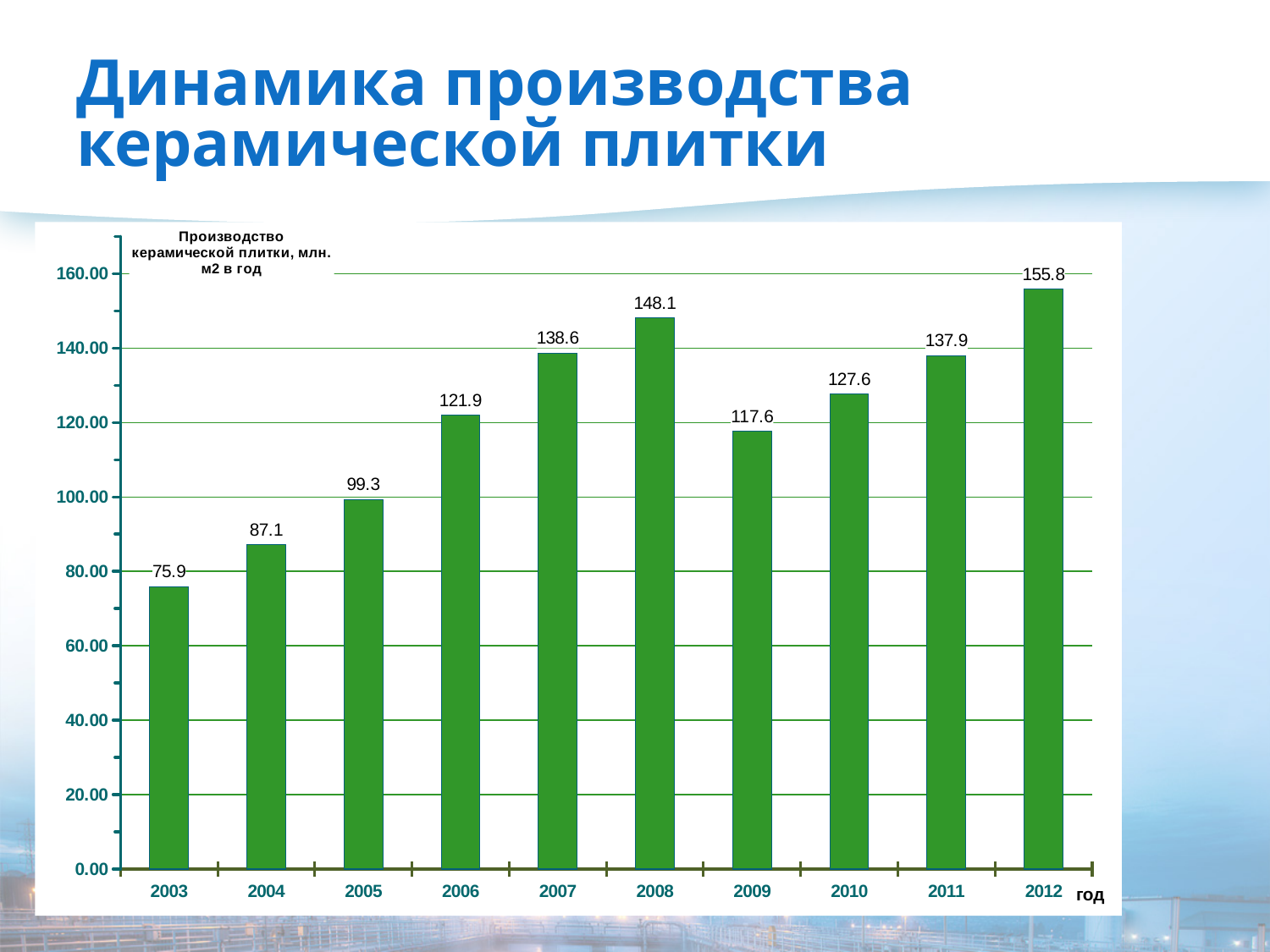
How many years are shown on the x axis? 10 Which is larger, the value for 2007 or the value for 2010? 2007 What is the value for 2008? 148.1 Which year has the lowest value? 2003 Which year has the highest value? 2012 What kind of chart is this? bar chart What is the value for 2003? 75.9 What is the value for 2009? 117.6 What is the title of the chart? Производство керамической плитки, млн. м2 в год What is the difference between the values for 2012 and 2011? 17.9 Is the value for 2006 greater or less than 120.00? greater What is the difference between the values for 2008 and 2009? 30.5